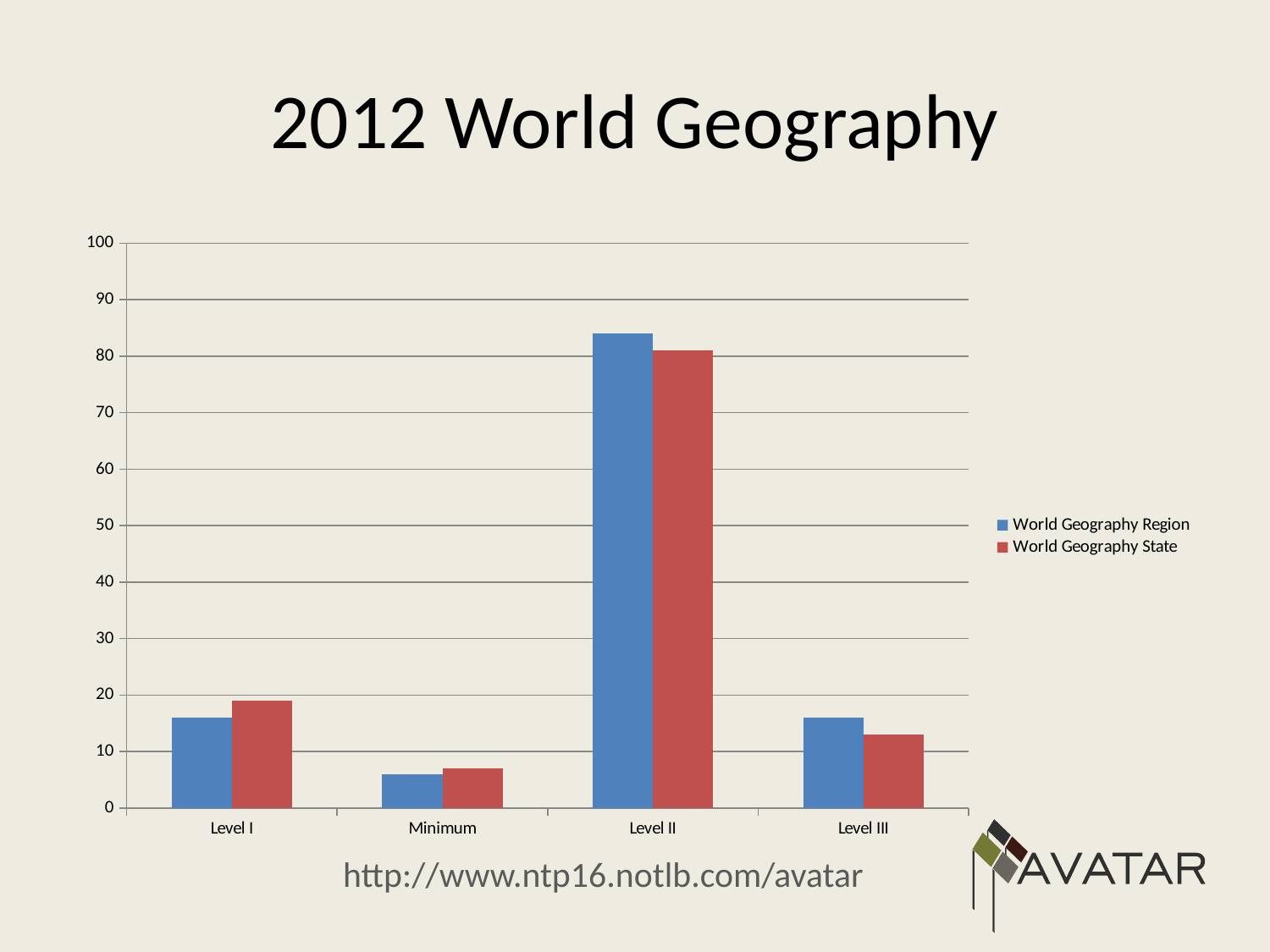
Is the value for World Geography State at Level II greater or less than 70? greater What kind of chart is shown on the slide? bar chart Which category has the highest value for World Geography Region? Level II Is the value for World Geography State at Level I greater or less than 20? less Is the value for World Geography Region at Level II greater or less than 80? greater How many categories are shown on the x axis? 4 At Level I, which series has the larger value, World Geography Region or World Geography State? World Geography State What is the title of the chart? 2012 World Geography Which category has the lowest value for World Geography State? Minimum At Level III, which series has the larger value, World Geography Region or World Geography State? World Geography Region How many series does the legend list? 2